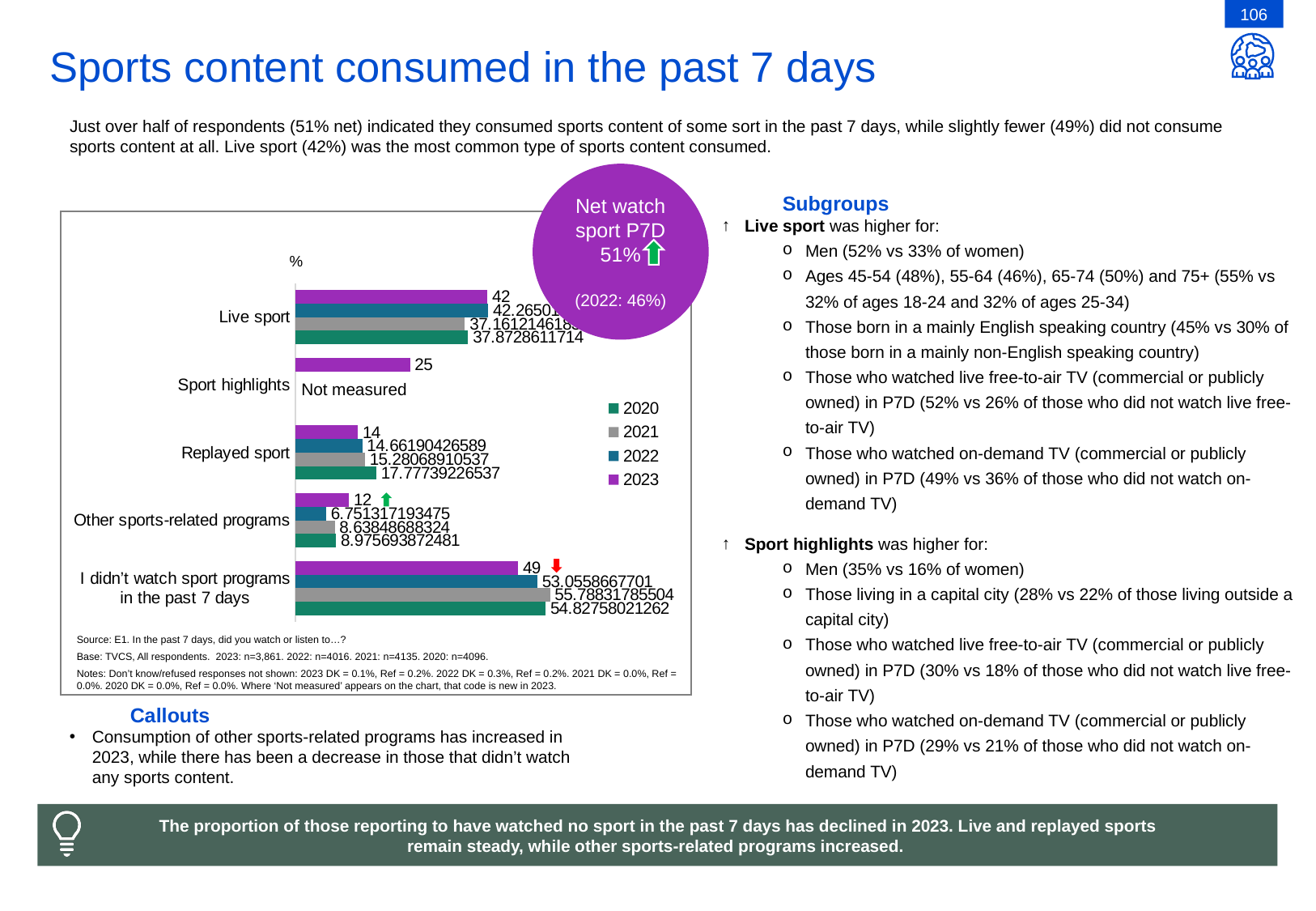
What is the difference between the 2023 values for 'I didn't watch sport programs in the past 7 days' and Live sport? 7 What is the 2020 value for Replayed sport? 17.77739226537 How many categories are shown on the chart? 5 Which category has the highest 2023 value? I didn't watch sport programs in the past 7 days What is the 2023 value for Live sport? 42 What kind of chart is shown on the slide? Bar chart Which is larger: the 2023 value for Replayed sport or the 2023 value for Other sports-related programs? Replayed sport What is the 2022 value for Other sports-related programs? 6.751317193475 How many series does the legend list? 4 What is the 2023 value for Sport highlights? 25 What is the 2021 value for 'I didn't watch sport programs in the past 7 days'? 55.78831785504 Which category has the lowest 2023 value? Other sports-related programs